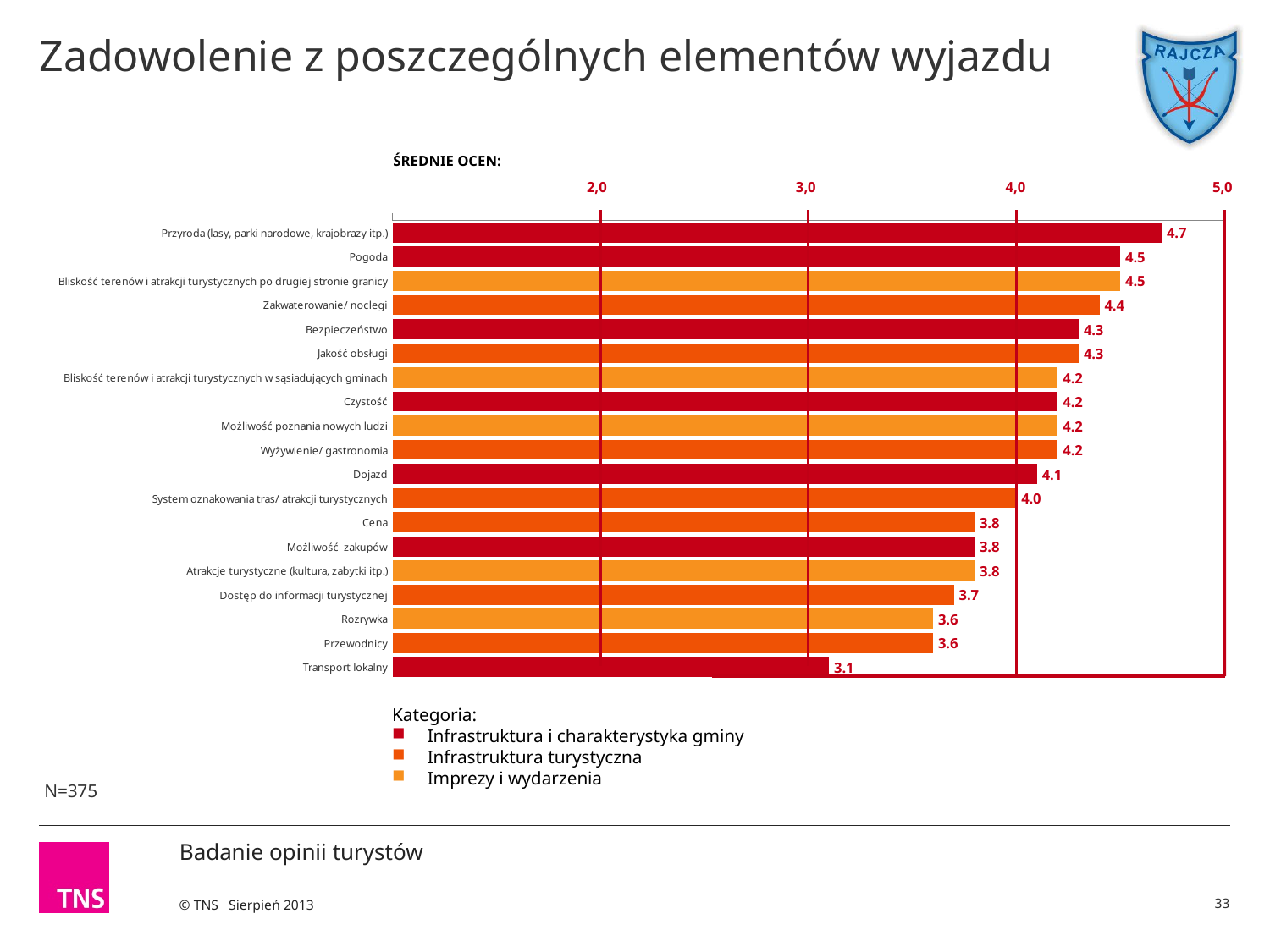
How many elements are rated in the chart? 19 Which element has the lowest average rating? Transport lokalny What is the average rating for Transport lokalny? 3.1 Is the average rating for Przewodnicy greater or less than 4,0? less What is the difference between the average rating for Przyroda (lasy, parki narodowe, krajobrazy itp.) and Transport lokalny? 1.6 What type of chart is shown on the slide? bar chart What is the average rating for Zakwaterowanie/ noclegi? 4.4 What is the difference between the average rating for Pogoda and Cena? 0.7 Which has a higher average rating, Dojazd or Rozrywka? Dojazd Which element has the highest average rating? Przyroda (lasy, parki narodowe, krajobrazy itp.) What is the average rating for Dostęp do informacji turystycznej? 3.7 How many categories does the legend under the chart list? 3